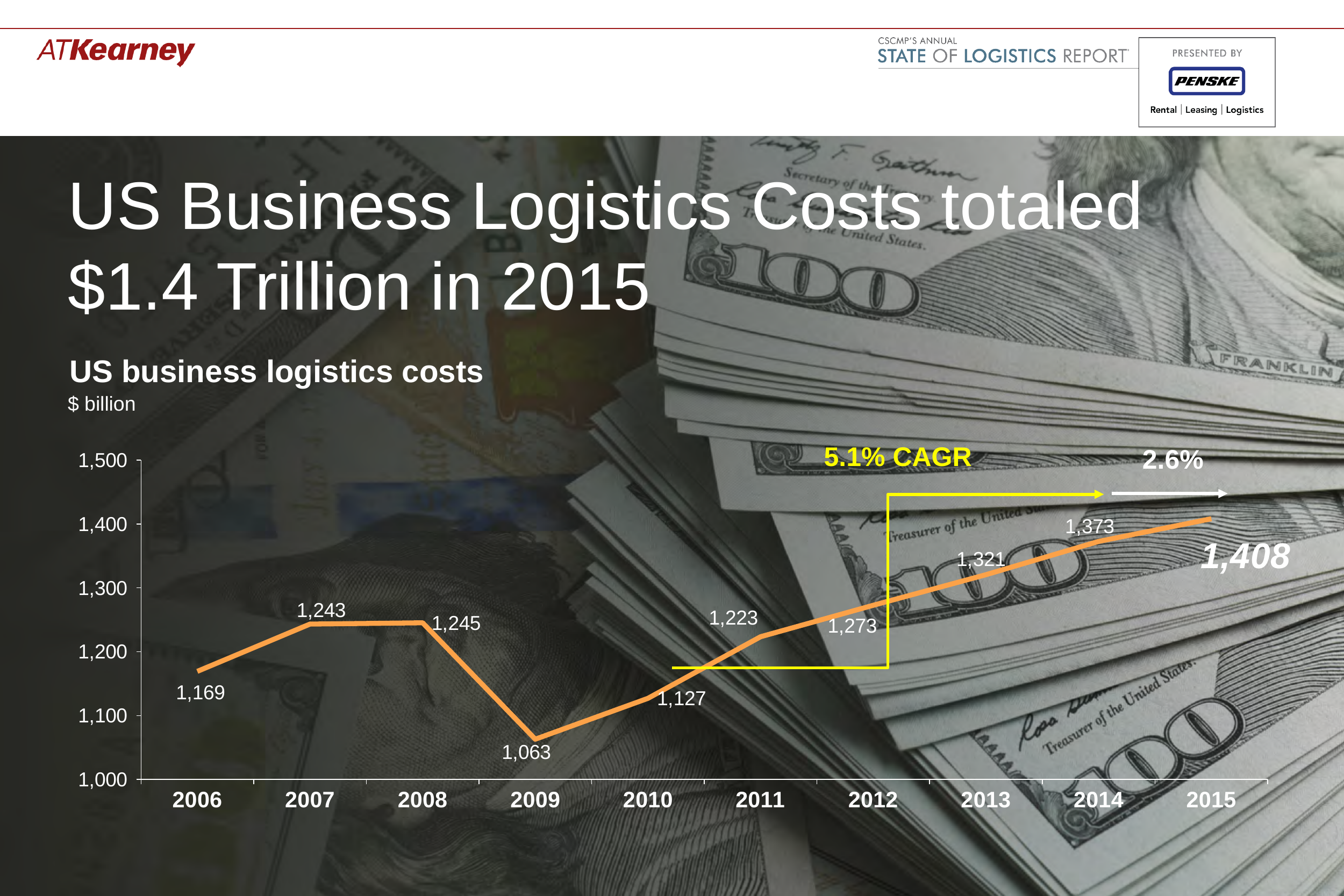
How many years are plotted on the chart? 10 What CAGR is labelled on the chart for the period starting in 2010? 5.1% CAGR What were US business logistics costs in 2009, in $ billion? 1,063 What is the difference in US business logistics costs between 2015 and 2014, in $ billion? 35 What type of chart is shown on the slide? Line chart Which year has the highest US business logistics costs? 2015 What were US business logistics costs in 2015, in $ billion? 1,408 What were US business logistics costs in 2012, in $ billion? 1,273 Which year has the lowest US business logistics costs? 2009 What is the difference in US business logistics costs between 2008 and 2009, in $ billion? 182 Which year had higher US business logistics costs, 2006 or 2011? 2011 Do US business logistics costs rise or fall from 2009 to 2015? Rise